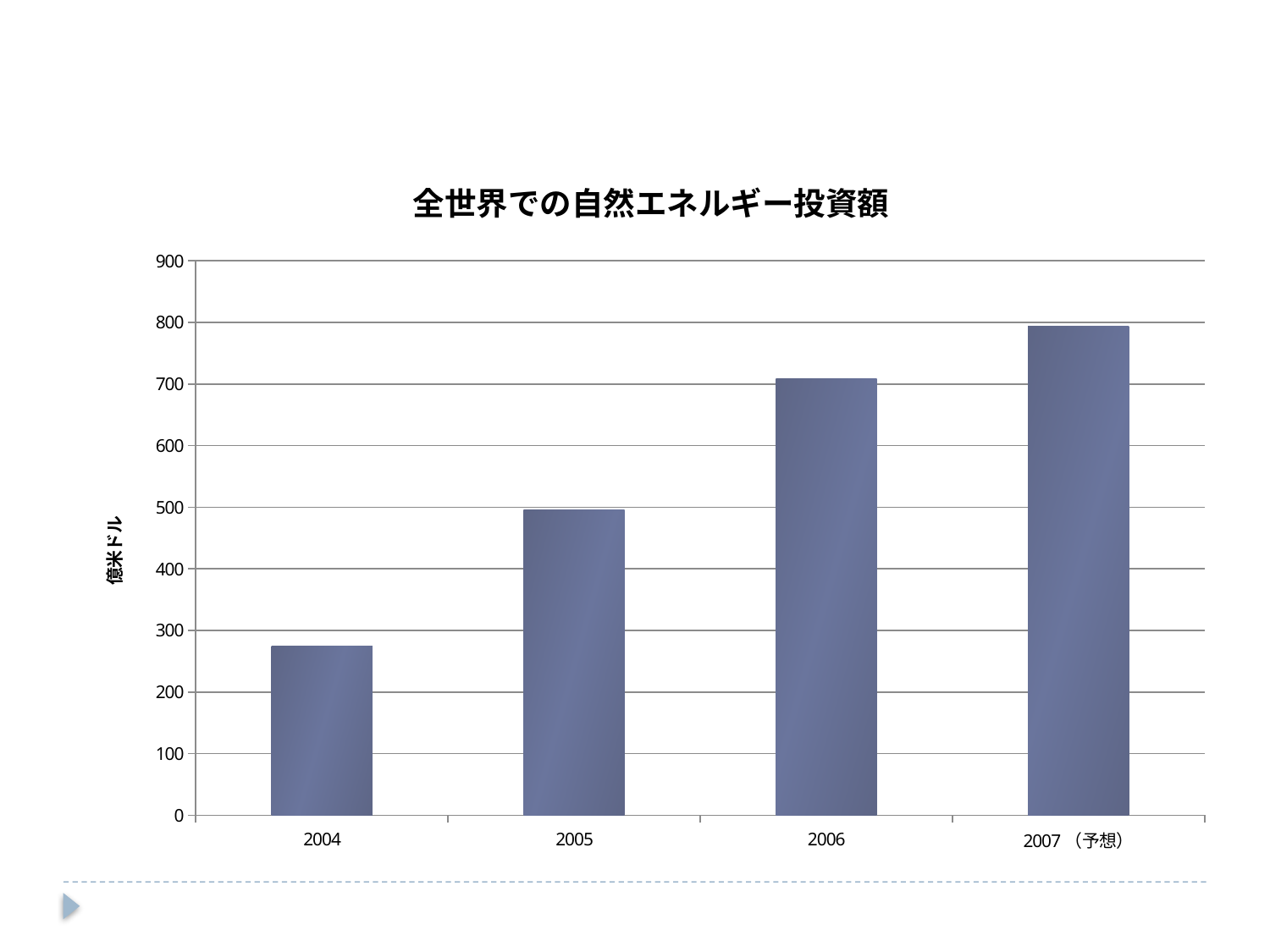
What kind of chart is shown on the slide? bar chart Which is larger, the value for 2005 or the value for 2006? 2006 Which year has the lowest value in the chart? 2004 Is the value for 2005 greater or less than 400? greater Is the value for 2006 greater or less than 600? greater What is the title of the chart? 全世界での自然エネルギー投資額 Is the value for 2007（予想） greater or less than 700? greater What is the label on the vertical axis of the chart? 億米ドル How many bars (categories) are plotted in the chart? 4 Which year has the highest value in the chart? 2007（予想） Do the values rise or fall from 2004 to 2007（予想）? rise